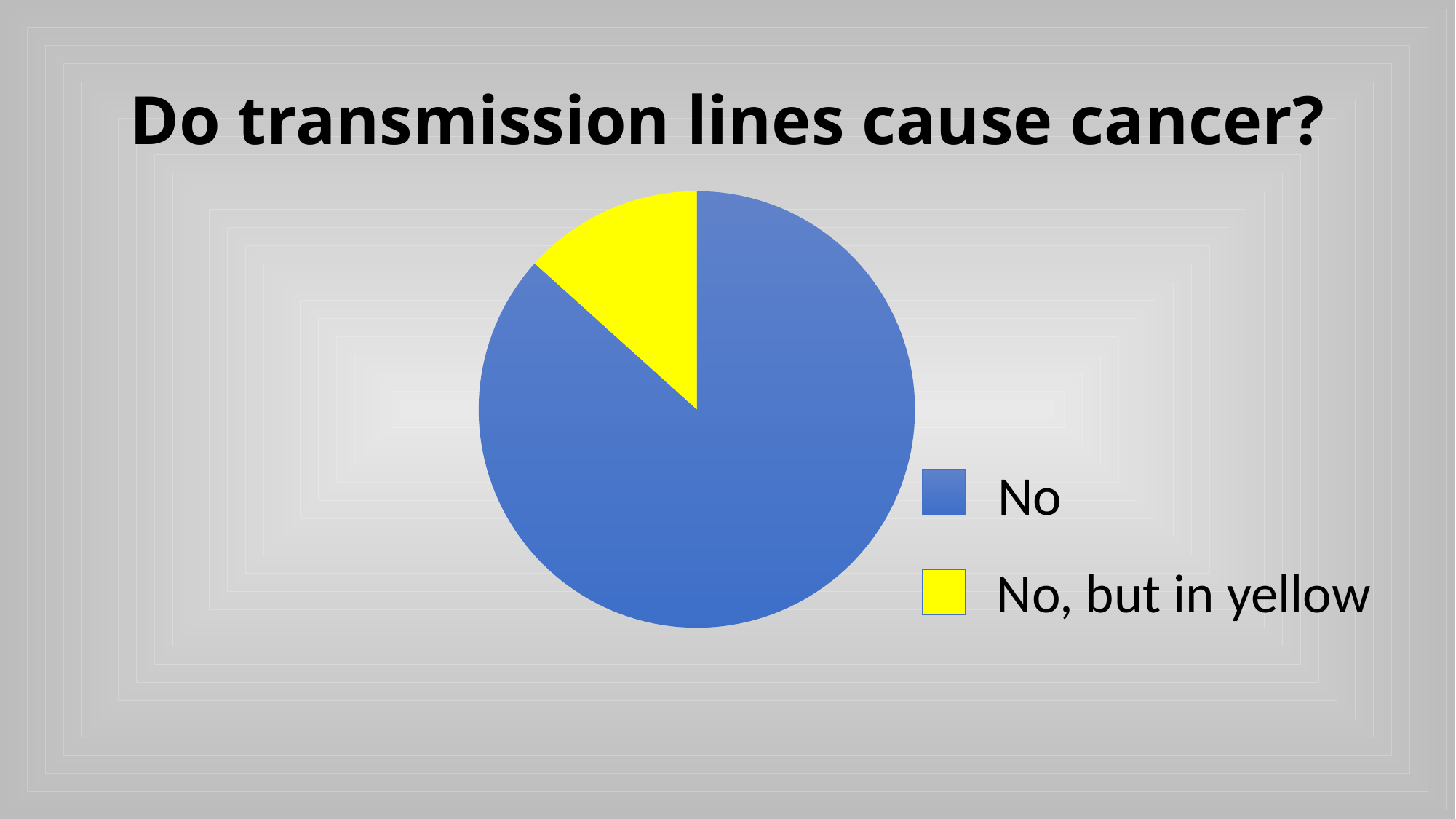
Which slice is larger, "No" or "No, but in yellow"? No What is the title of the slide containing the pie chart? Do transmission lines cause cancer? How many slices does the pie chart have? 2 What kind of chart is shown on the slide? pie chart Which slice is the largest in the pie chart? No What colour is the slice labelled "No"? blue Which slice is the smallest in the pie chart? No, but in yellow How many entries does the legend list? 2